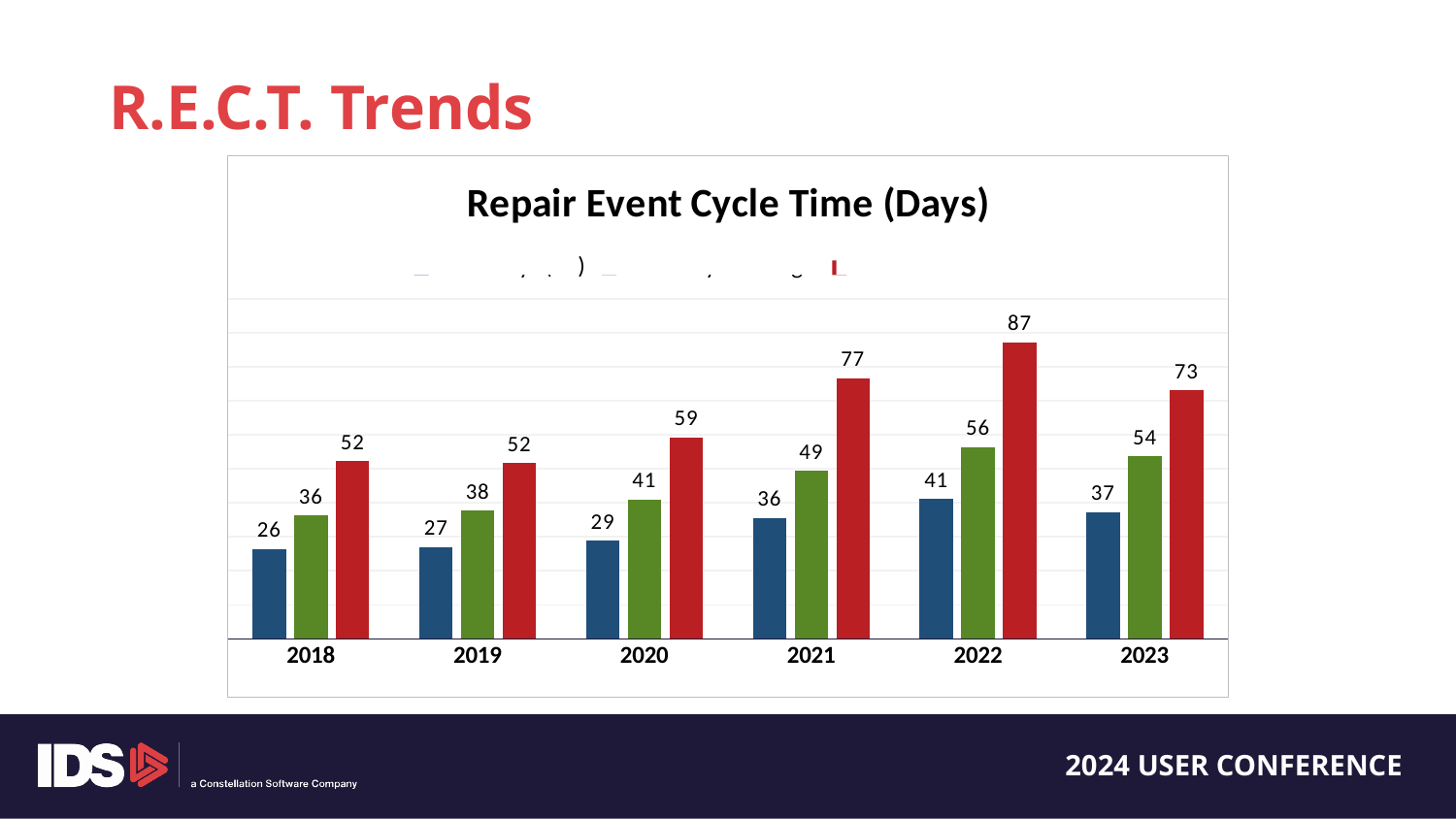
In which year is the red bar highest? 2022 What type of chart is shown on the slide? bar chart In which year is the blue bar lowest? 2018 What is the value of the red bar for 2022? 87 Does the red bar rise or fall from 2018 to 2022? rise What is the value of the green bar for 2021? 49 How many years are shown on the x axis? 6 Which is larger, the green bar in 2020 or the green bar in 2019? the green bar in 2020 What is the difference between the red bar and the blue bar in 2023? 36 What is the value of the blue bar for 2018? 26 What is the title of the chart? Repair Event Cycle Time (Days) How many bars are plotted for each year? 3